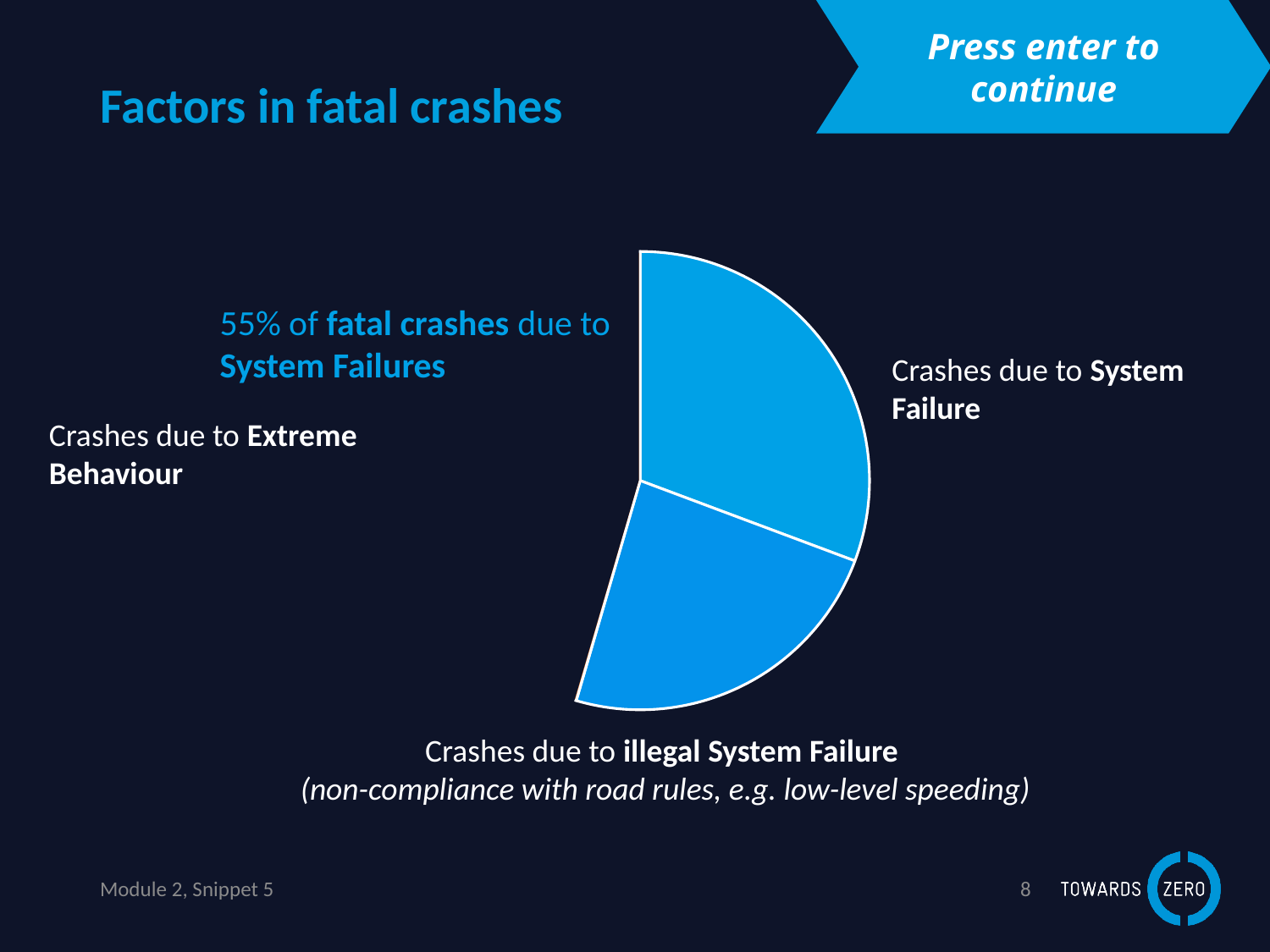
According to the slide, what share of fatal crashes is due to System Failures? 55% What kind of chart is shown on the slide? pie chart Which category is labelled below the pie chart? Crashes due to illegal System Failure How many crash categories are labelled around the pie chart? 3 Which slice is larger: Crashes due to System Failure or Crashes due to illegal System Failure? Crashes due to System Failure What is the title of the slide containing the chart? Factors in fatal crashes